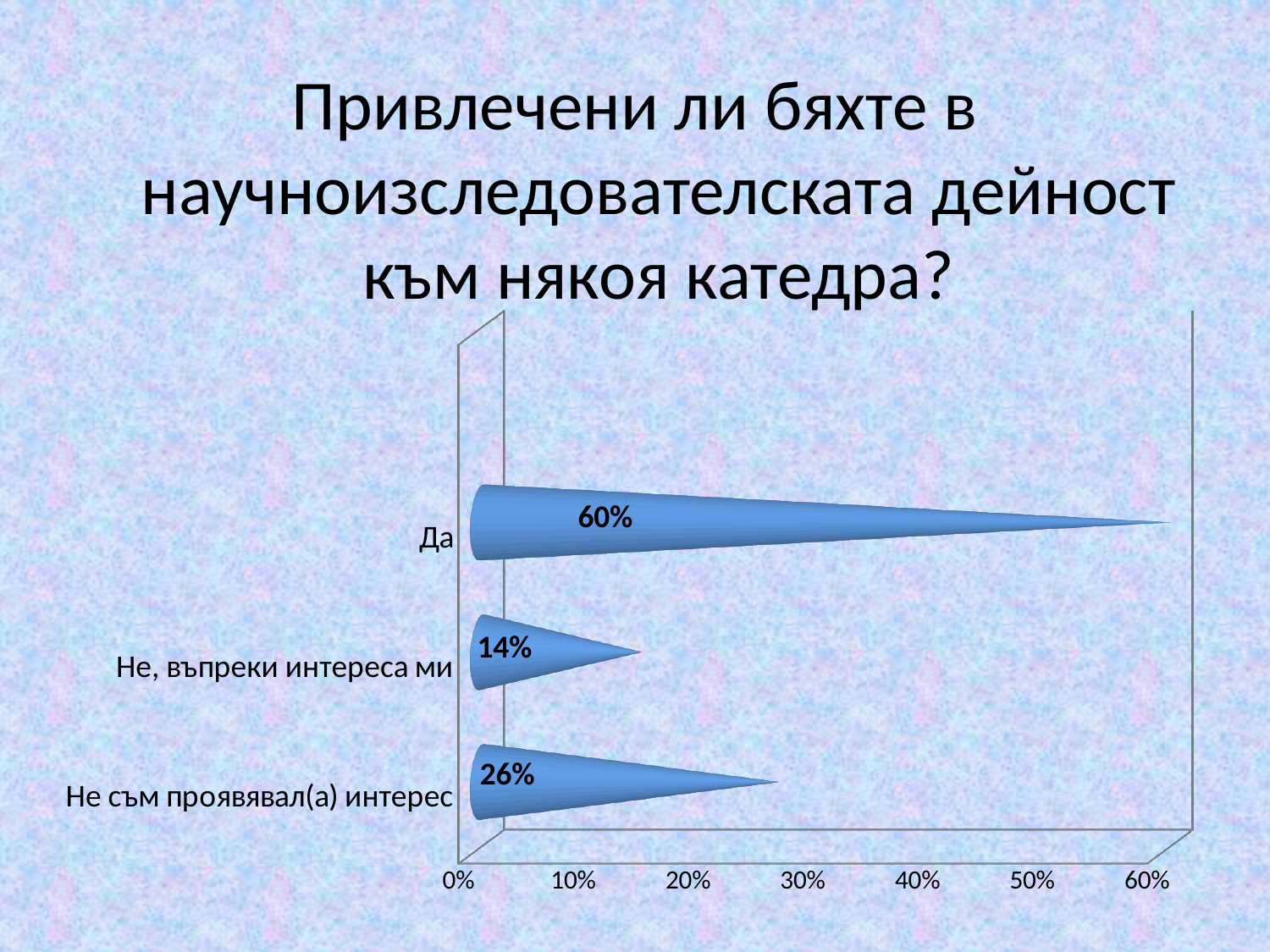
What is the difference between the values for "Да" and "Не съм проявявал(а) интерес"? 34% What is the value for "Не съм проявявал(а) интерес"? 26% What is the value for "Не, въпреки интереса ми"? 14% Which is larger, the value for "Не съм проявявал(а) интерес" or the value for "Не, въпреки интереса ми"? Не съм проявявал(а) интерес What is the title of the slide? Привлечени ли бяхте в научноизследователската дейност към някоя катедра? What is the difference between the values for "Не съм проявявал(а) интерес" and "Не, въпреки интереса ми"? 12% Which category has the highest value? Да What kind of chart is shown on the slide? bar chart How many categories are shown in the chart? 3 Which category has the lowest value? Не, въпреки интереса ми Is the value for "Не съм проявявал(а) интерес" greater or less than 20%? greater What is the value for "Да"? 60%